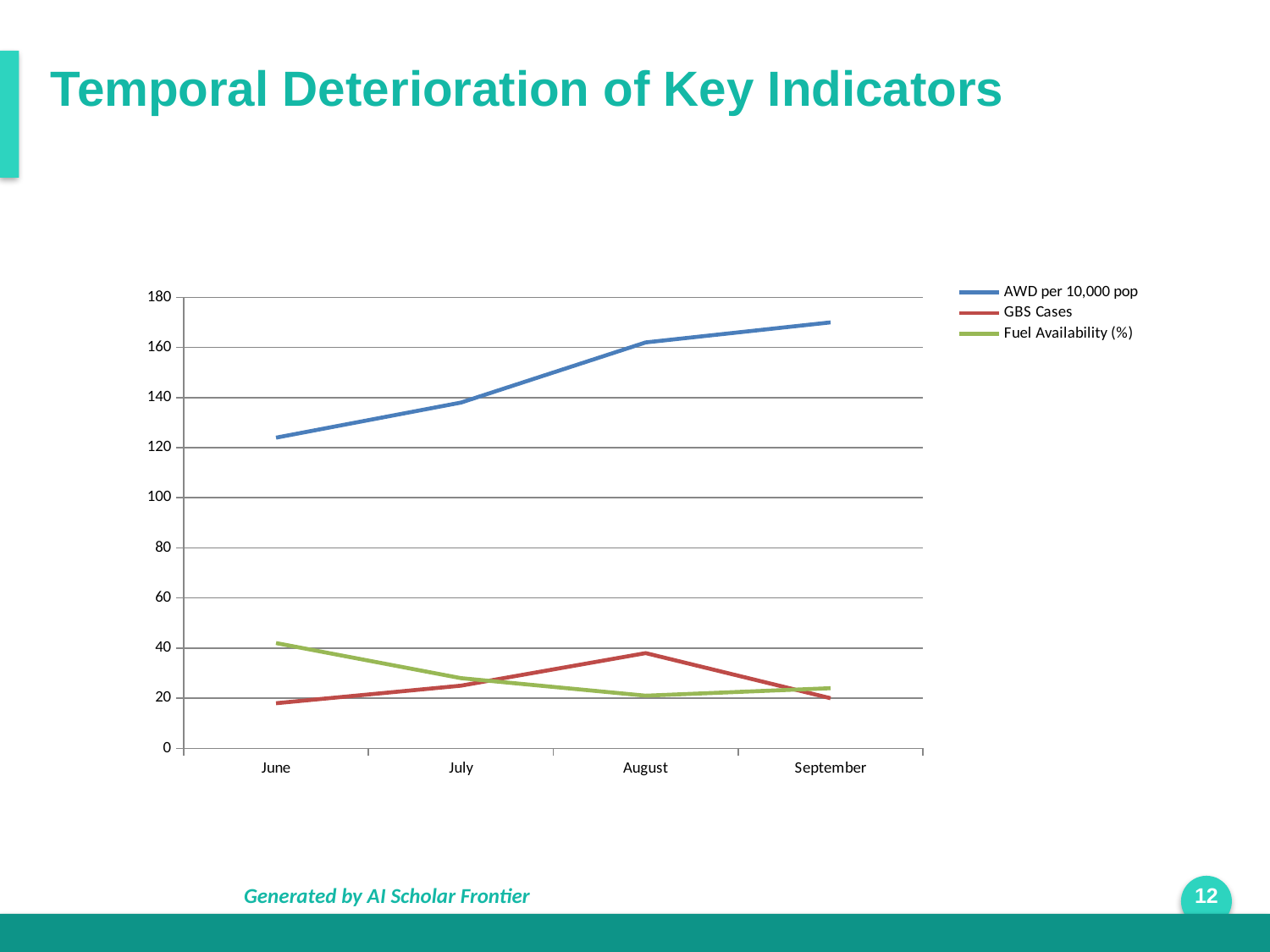
In which month is Fuel Availability (%) highest? June What kind of chart is shown on the slide? line chart Does AWD per 10,000 pop rise or fall from June to September? rise Which is larger in July, AWD per 10,000 pop or Fuel Availability (%)? AWD per 10,000 pop In which month is AWD per 10,000 pop highest? September How many series does the legend list? 3 How many months are plotted along the x axis? 4 Is the value for GBS Cases in August greater or less than 20? greater In which month are GBS Cases highest? August Is the value for AWD per 10,000 pop in September greater or less than 160? greater Is the value for AWD per 10,000 pop in June greater or less than 140? less In which month is AWD per 10,000 pop lowest? June